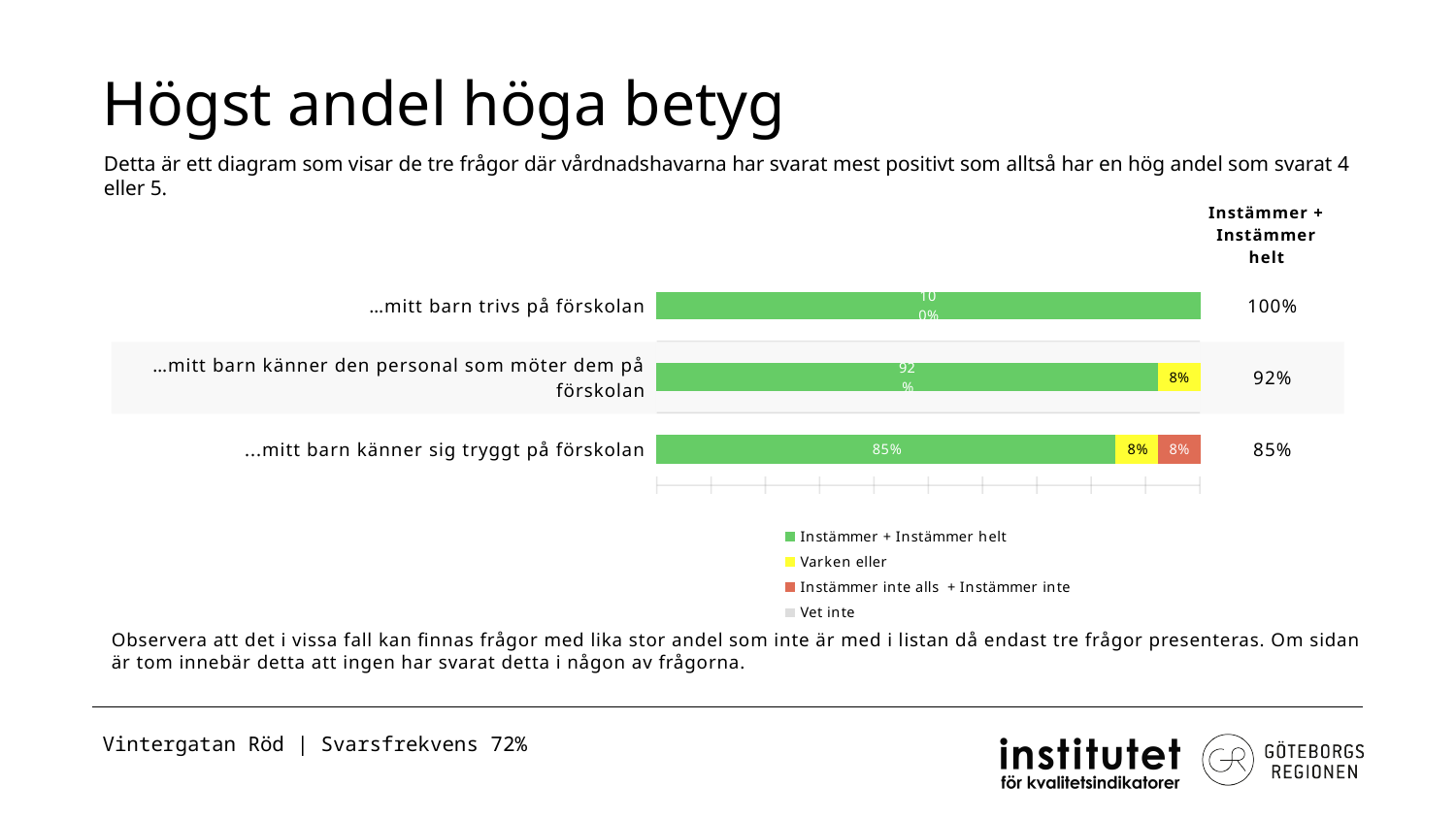
Which question has the lowest 'Instämmer + Instämmer helt' share? …mitt barn känner sig tryggt på förskolan How many series does the legend list? 4 What is the 'Varken eller' share for '…mitt barn känner sig tryggt på förskolan'? 8% What is the 'Instämmer inte alls + Instämmer inte' share for '…mitt barn känner sig tryggt på förskolan'? 8% What is the difference in 'Instämmer + Instämmer helt' share between '…mitt barn trivs på förskolan' and '…mitt barn känner sig tryggt på förskolan'? 15% Which legend entry is shown in yellow? Varken eller How many questions (categories) are shown in the chart? 3 What is the 'Instämmer + Instämmer helt' share for '…mitt barn trivs på förskolan'? 100% Which question has the highest 'Instämmer + Instämmer helt' share? …mitt barn trivs på förskolan What is the 'Instämmer + Instämmer helt' share for '…mitt barn känner den personal som möter dem på förskolan'? 92% What kind of chart is shown on the slide? Stacked bar chart What is the 'Instämmer + Instämmer helt' share for '…mitt barn känner sig tryggt på förskolan'? 85%